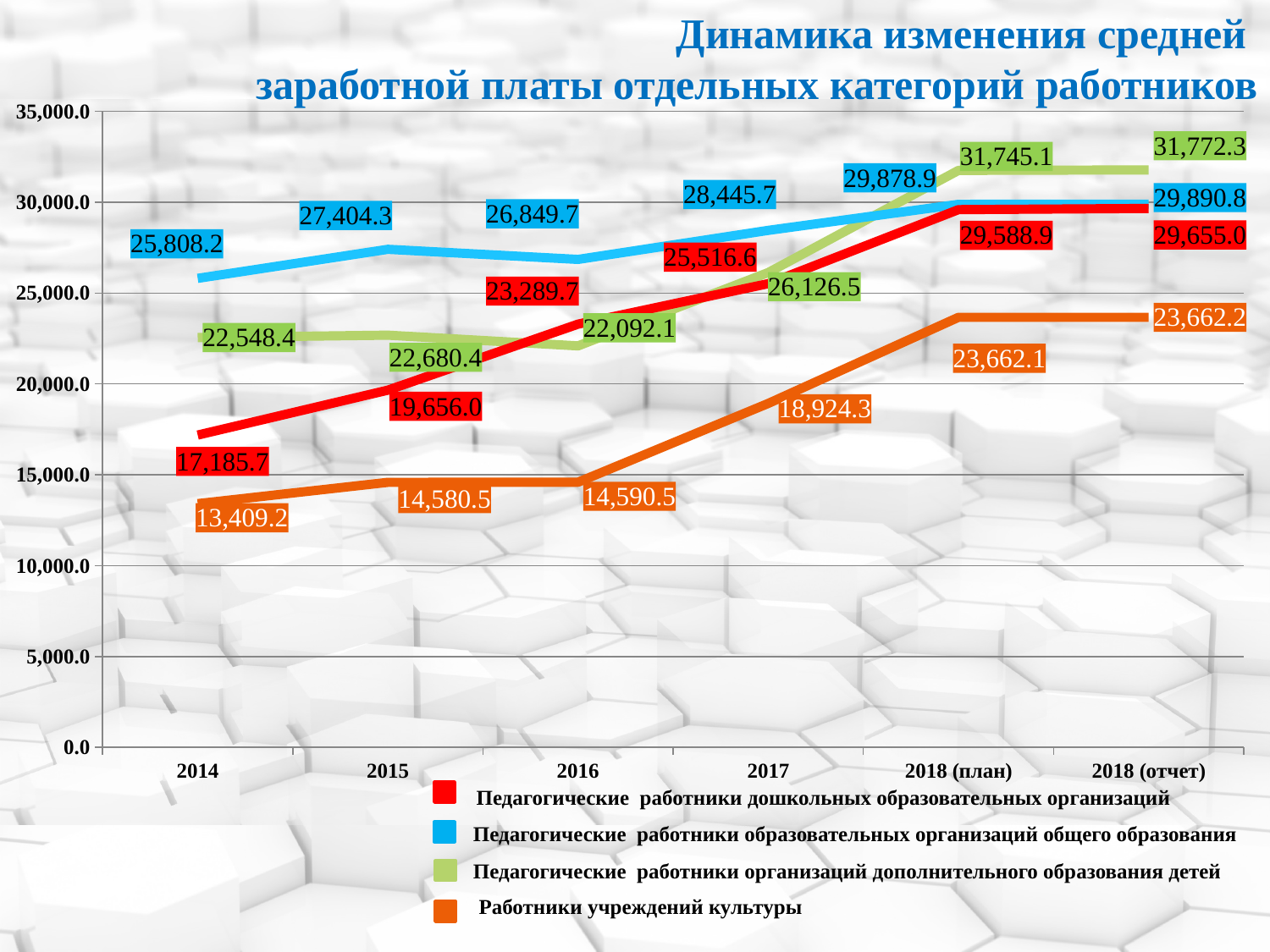
In 2016, which is larger: the value for Педагогические работники образовательных организаций общего образования or for Педагогические работники организаций дополнительного образования детей? Педагогические работники образовательных организаций общего образования In which year does the Педагогические работники организаций дополнительного образования детей series reach its highest value? 2018 (отчет) What kind of chart is shown on the slide? line chart What is the value for Педагогические работники образовательных организаций общего образования in 2017? 28,445.7 Is the 2017 value for Работники учреждений культуры greater or less than 20,000.0? less Does the value for Педагогические работники дошкольных образовательных организаций rise or fall from 2014 to 2018 (отчет)? rise In which year is the value for Работники учреждений культуры lowest? 2014 How many time points are plotted on the x axis? 6 What is the value for Педагогические работники дошкольных образовательных организаций in 2018 (план)? 29,588.9 What is the value for Работники учреждений культуры in 2014? 13,409.2 What is the difference between the 2014 values for Педагогические работники образовательных организаций общего образования and Работники учреждений культуры? 12,399.0 How many series does the legend list? 4